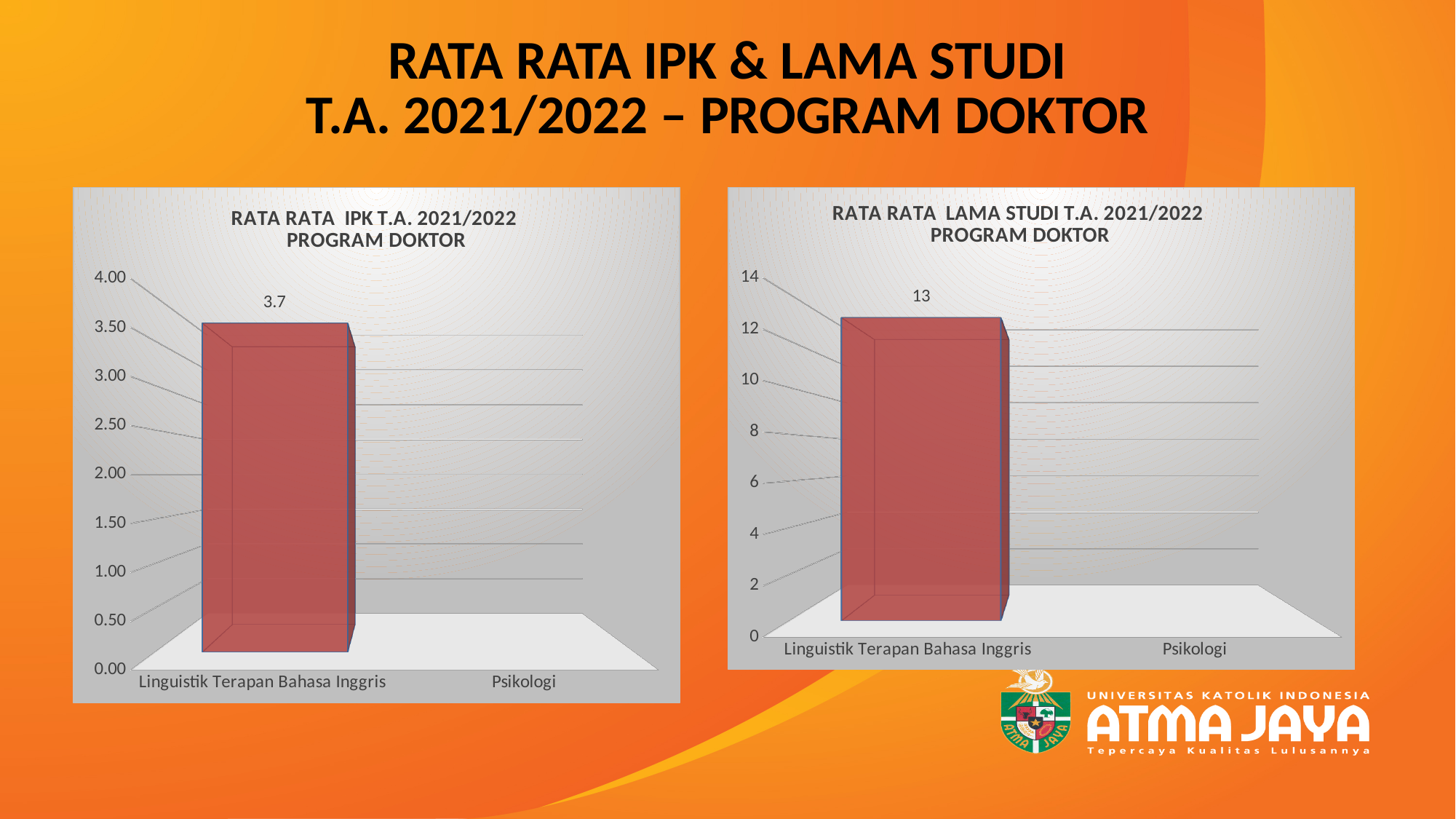
In the left chart (RATA RATA IPK), is the value for Linguistik Terapan Bahasa Inggris greater or less than 3.00? greater In the chart titled "RATA RATA IPK T.A. 2021/2022 PROGRAM DOKTOR", what is the value for Linguistik Terapan Bahasa Inggris? 3.7 What is the title of the right chart on the slide? RATA RATA LAMA STUDI T.A. 2021/2022 PROGRAM DOKTOR In the right chart (RATA RATA LAMA STUDI), which category has the highest value? Linguistik Terapan Bahasa Inggris In the right chart (RATA RATA LAMA STUDI), is the value for Linguistik Terapan Bahasa Inggris greater or less than 12? greater How many categories are shown on the x axis of the left chart (RATA RATA IPK)? 2 In the left chart (RATA RATA IPK), which category has the highest value? Linguistik Terapan Bahasa Inggris What kind of chart is the right chart on the slide? bar chart What is the highest tick value on the vertical axis of the left chart (RATA RATA IPK)? 4.00 How many categories are shown on the x axis of the right chart (RATA RATA LAMA STUDI)? 2 In the chart titled "RATA RATA LAMA STUDI T.A. 2021/2022 PROGRAM DOKTOR", what is the value for Linguistik Terapan Bahasa Inggris? 13 What kind of chart is the left chart on the slide? bar chart